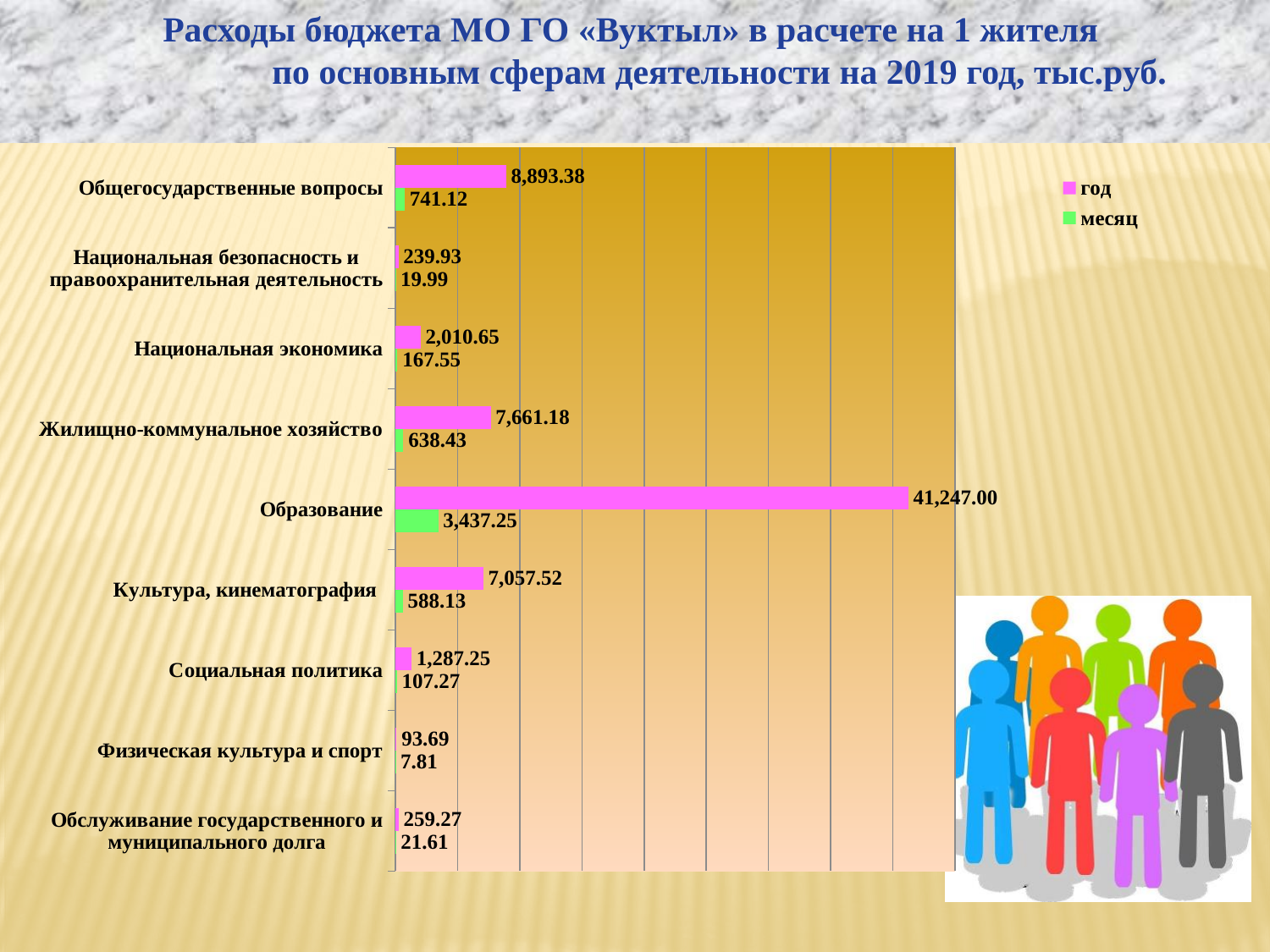
Which is larger: the "год" value for Культура, кинематография or for Жилищно-коммунальное хозяйство? Жилищно-коммунальное хозяйство Which category has the lowest "месяц" value? Физическая культура и спорт Which category has the highest "год" value? Образование How many categories are shown on the chart? 9 How many series does the legend list? 2 What is the "год" value for Социальная политика? 1,287.25 What is the difference between the "год" values for Общегосударственные вопросы and Жилищно-коммунальное хозяйство? 1,232.20 What is the value of the "месяц" series for Жилищно-коммунальное хозяйство? 638.43 Which colour represents the "месяц" series in the legend? Green What is the "месяц" value for Физическая культура и спорт? 7.81 What type of chart is shown on the slide? Bar chart What is the value of the "год" series for Образование? 41,247.00